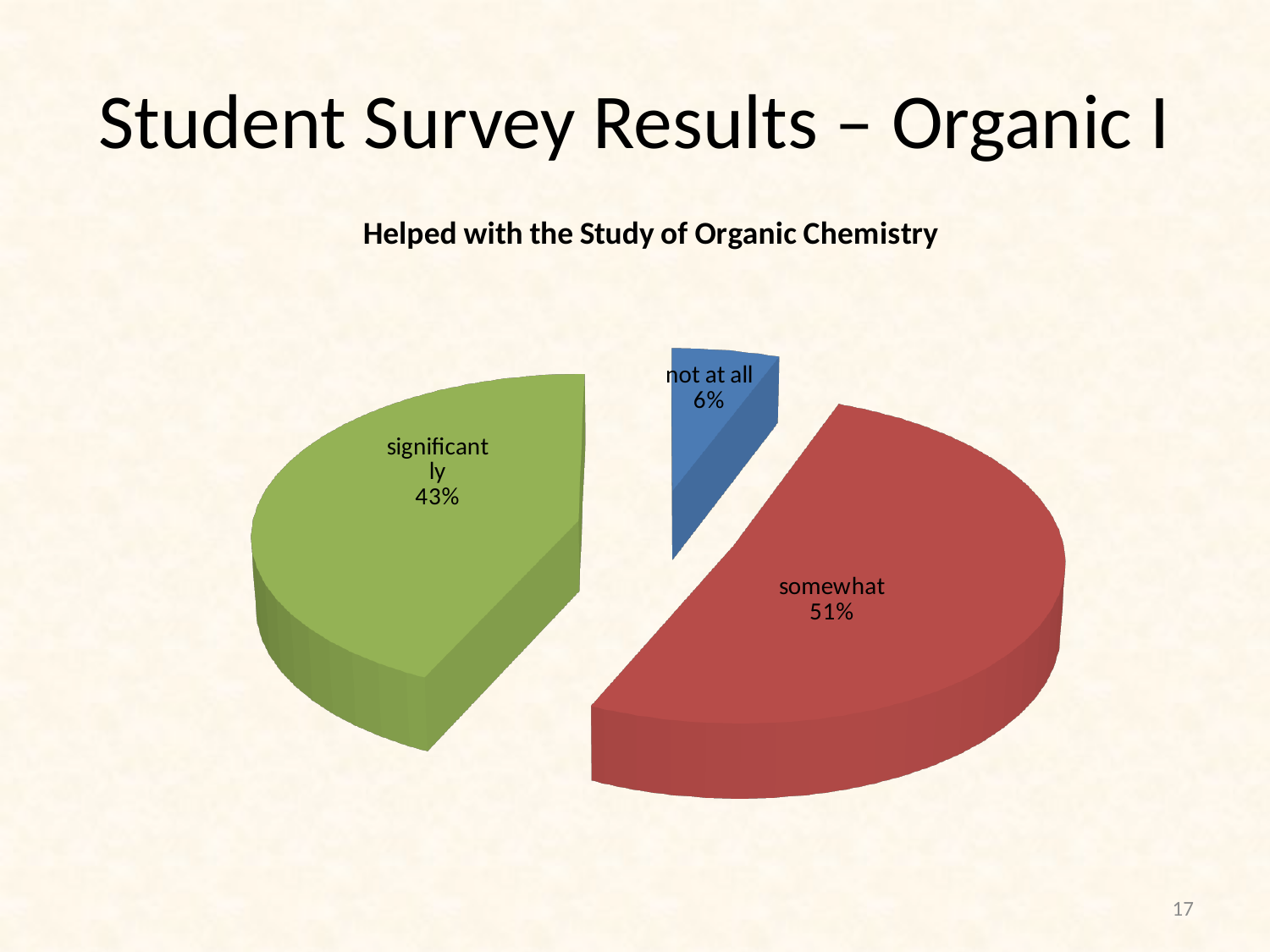
What percentage of students answered "significantly"? 43% What is the difference in percentage points between "somewhat" and "significantly"? 8 What is the title of the chart? Helped with the Study of Organic Chemistry What percentage of students answered "somewhat"? 51% What colour is the "somewhat" slice? red How many slices does the pie chart have? 3 Which response has the smallest share of the pie? not at all What is the difference in percentage points between "significantly" and "not at all"? 37 Which is larger, the share for "significantly" or the share for "not at all"? significantly What percentage of students answered "not at all"? 6% What kind of chart is shown on the slide? pie chart Which response has the largest share of the pie? somewhat